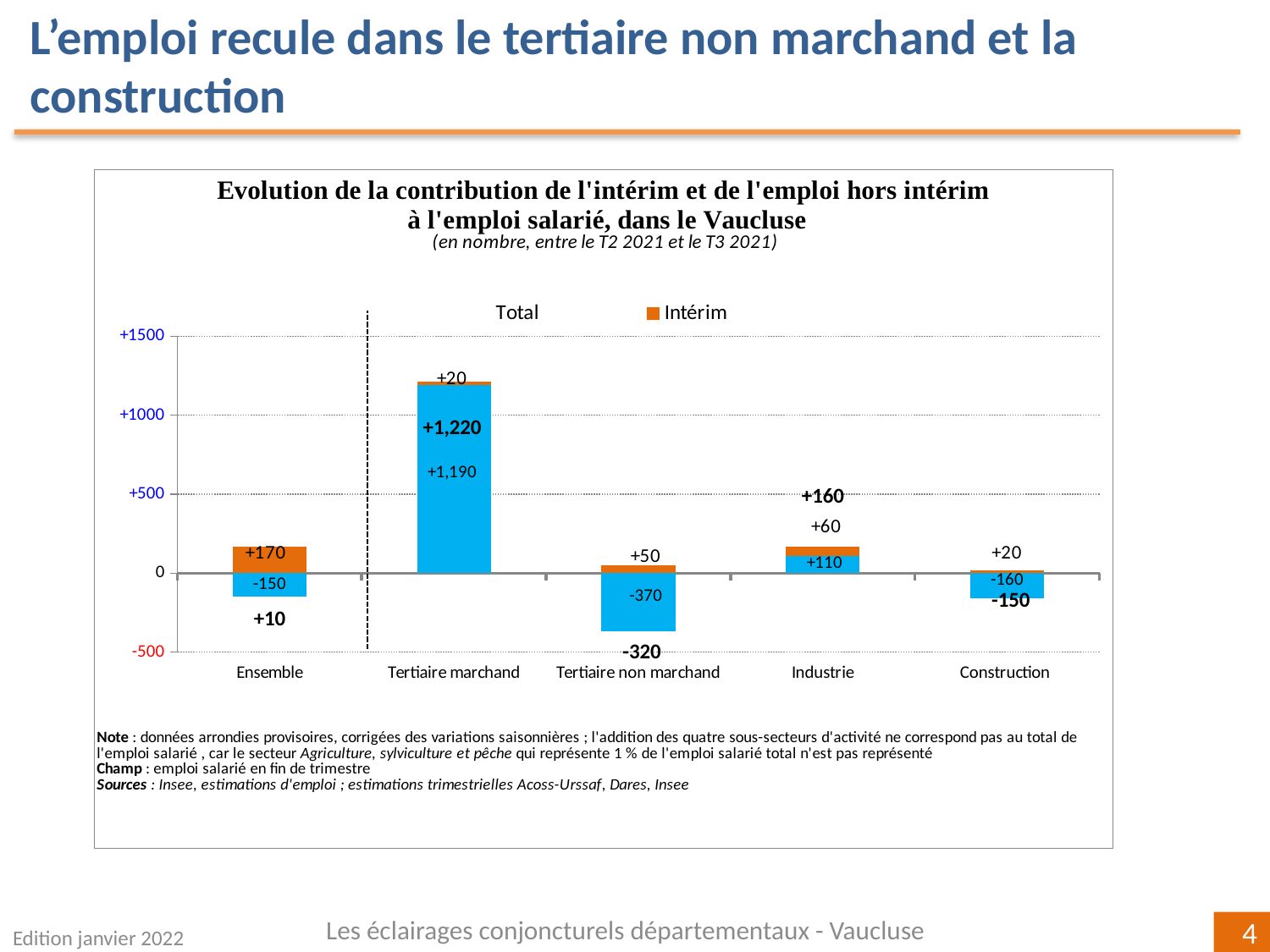
What is the value of the blue (hors intérim) segment for Tertiaire non marchand? -370 How many categories are shown on the x axis? 5 What is the Intérim value for Ensemble? +170 What is the total value shown for Construction? -150 What kind of chart is this? Bar chart Which category has the lowest total value? Tertiaire non marchand What is the Intérim value for Industrie? +60 What colour represents the Intérim series in the legend? Orange What is the total value shown for Tertiaire marchand? +1,220 What is the difference between the Intérim value for Ensemble (+170) and the Intérim value for Tertiaire non marchand (+50)? 120 Which category has the highest total value? Tertiaire marchand Which is larger: the total for Industrie or the total for Ensemble? Industrie